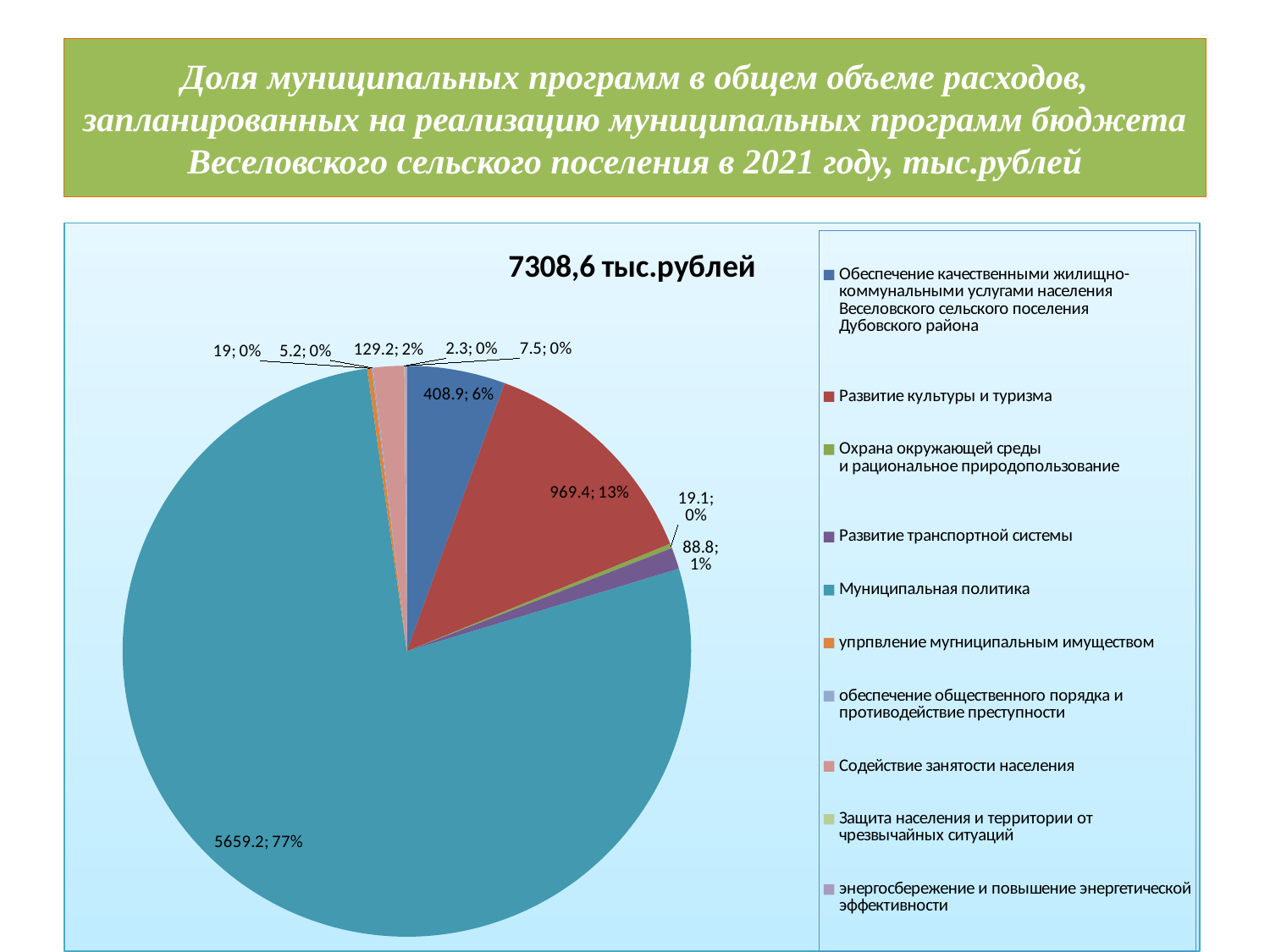
Which category has the largest slice of the pie? Муниципальная политика What share of the pie does Муниципальная политика take? 77% What is the value for Развитие транспортной системы? 88.8 Which category has the smallest value in the pie chart? Защита населения и территории от чрезвычайных ситуаций What is the value for Муниципальная политика? 5659.2 What is the difference between the values for Развитие культуры и туризма and Обеспечение качественными жилищно-коммунальными услугами населения? 560.5 What total amount is shown in the chart title? 7308,6 тыс.рублей What is the value for Развитие культуры и туризма? 969.4 What type of chart is shown on the slide? pie chart How many categories does the legend list? 10 What share of the pie does Развитие культуры и туризма take? 13% What is the value for Содействие занятости населения? 129.2